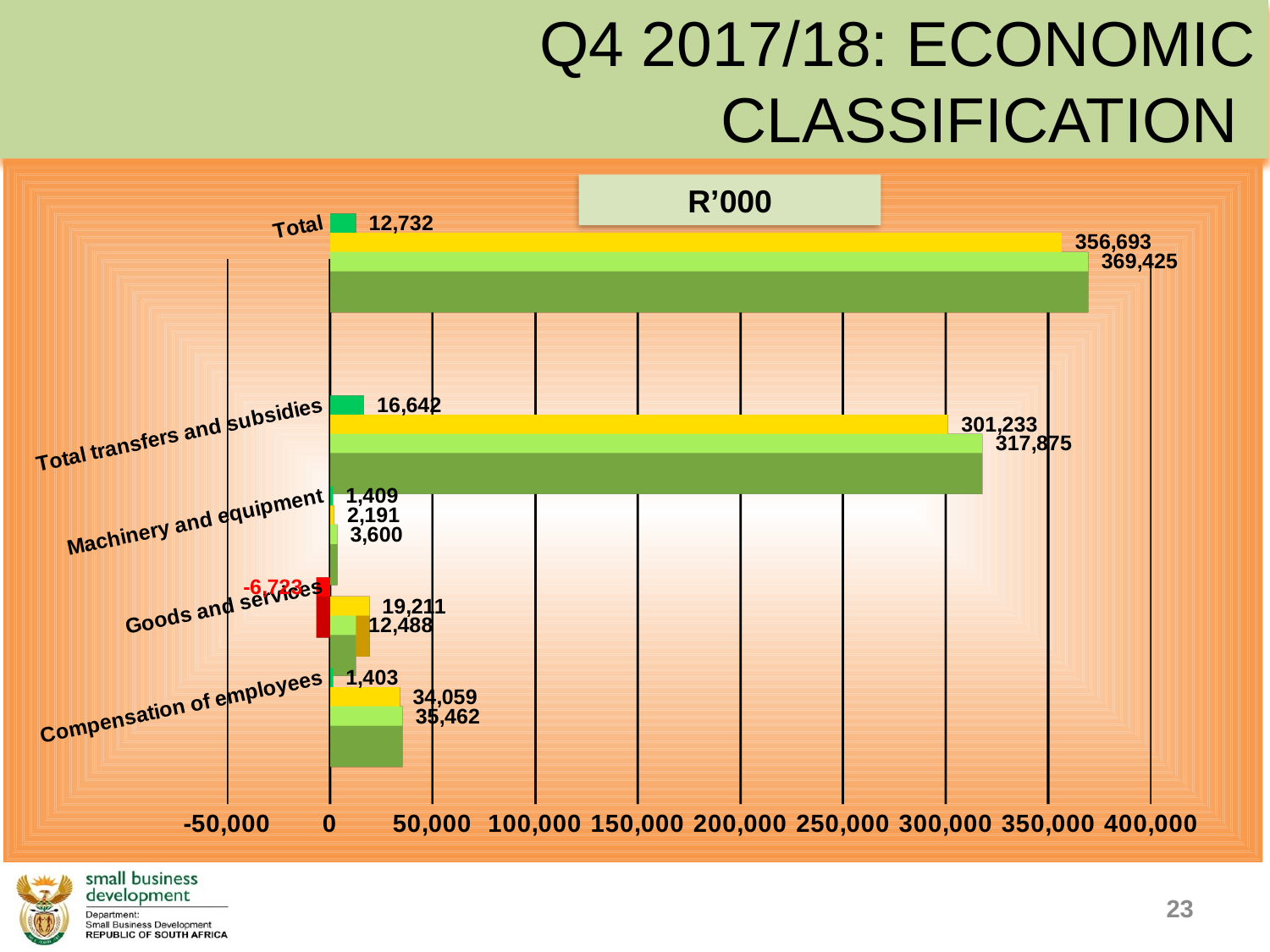
What is the value of the yellow bar for Total transfers and subsidies? 301,233 What is the largest value labelled for the Total category? 369,425 Which is larger: the yellow bar for Compensation of employees or the yellow bar for Goods and services? Compensation of employees Is the value of the yellow bar for Total transfers and subsidies greater or less than 300,000? greater How many categories are shown on the chart? 5 What is the value of the light green bar for Compensation of employees? 35,462 Which category has the smallest light green bar? Machinery and equipment What kind of chart is shown on the slide? bar chart What is the value of the light green bar for Machinery and equipment? 3,600 What unit label is shown in the box above the chart? R'000 What is the value of the yellow bar for Goods and services? 19,211 What is the difference between the two largest values labelled for Total (369,425 and 356,693)? 12,732